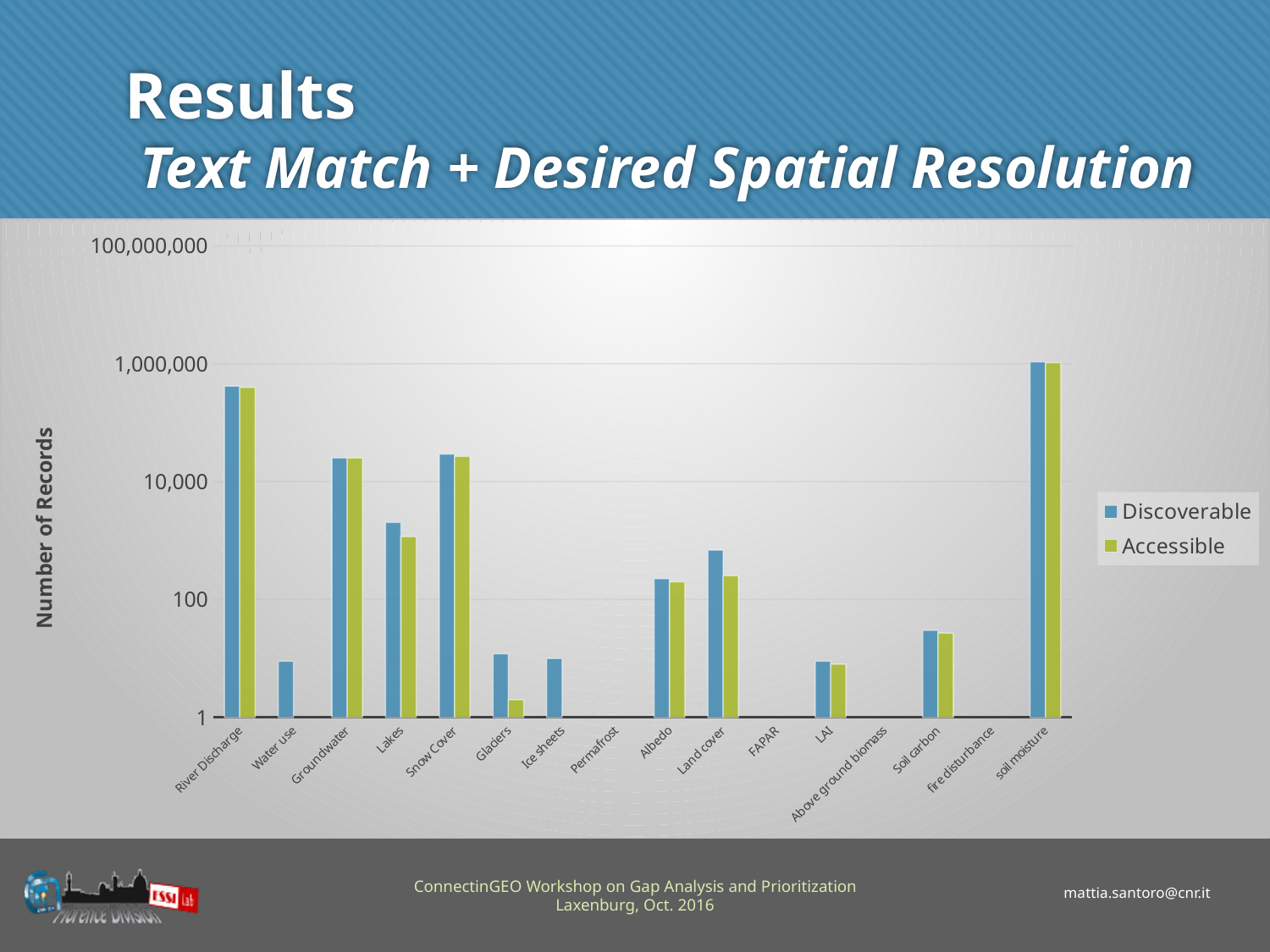
Is the Discoverable value for River Discharge greater or less than 10,000? greater Is the Discoverable value for Land cover greater or less than 100? greater Is the Discoverable value for Soil carbon greater or less than 100? less For Glaciers, which is larger, the Discoverable value or the Accessible value? Discoverable How many categories are shown on the x axis? 16 Which is larger, the Discoverable value for Land cover or the Discoverable value for Albedo? Land cover What is the label of the y axis? Number of Records How many series does the legend list? 2 What kind of chart is shown on the slide? bar chart Which category has the highest Discoverable value? soil moisture